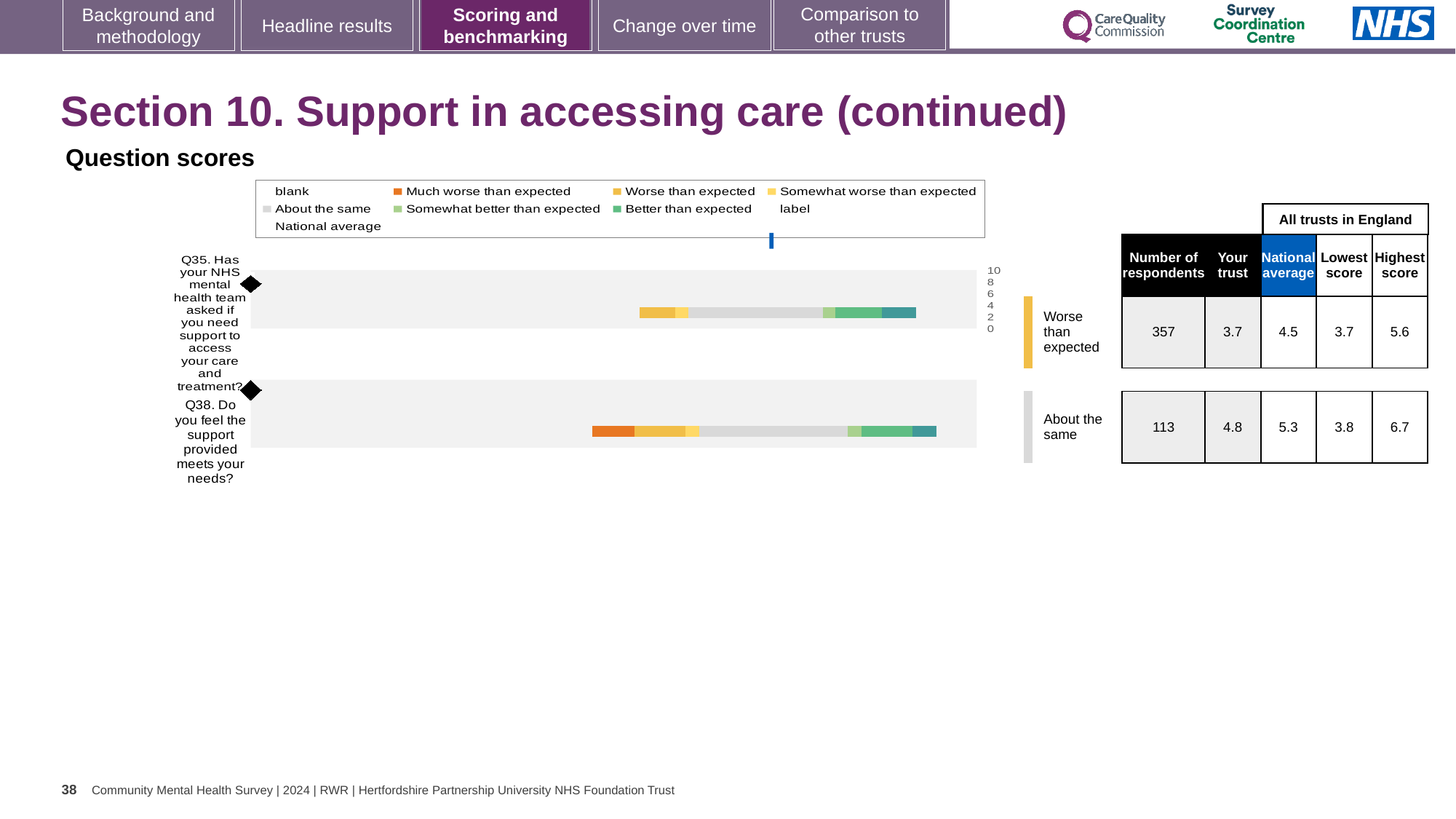
What benchmark category is Q35 placed in? Worse than expected What is the national average score for Q38 (Do you feel the support provided meets your needs?)? 5.3 Which legend entry is shown with an orange colour in the question scores chart? Much worse than expected What benchmark category is Q38 placed in? About the same What is the difference between the highest and lowest scores across all trusts in England for Q38? 2.9 What is the 'Your trust' score for Q35 (Has your NHS mental health team asked if you need support to access your care and treatment?)? 3.7 What is the difference between the national average and the 'Your trust' score for Q35? 0.8 What kind of chart is used to show the question scores on this slide? Bar chart How many questions (categories) are plotted in the question scores chart? 2 Which question has the higher 'Your trust' score, Q35 or Q38? Q38 What is the highest score across all trusts in England for Q38? 6.7 How many respondents answered Q35? 357